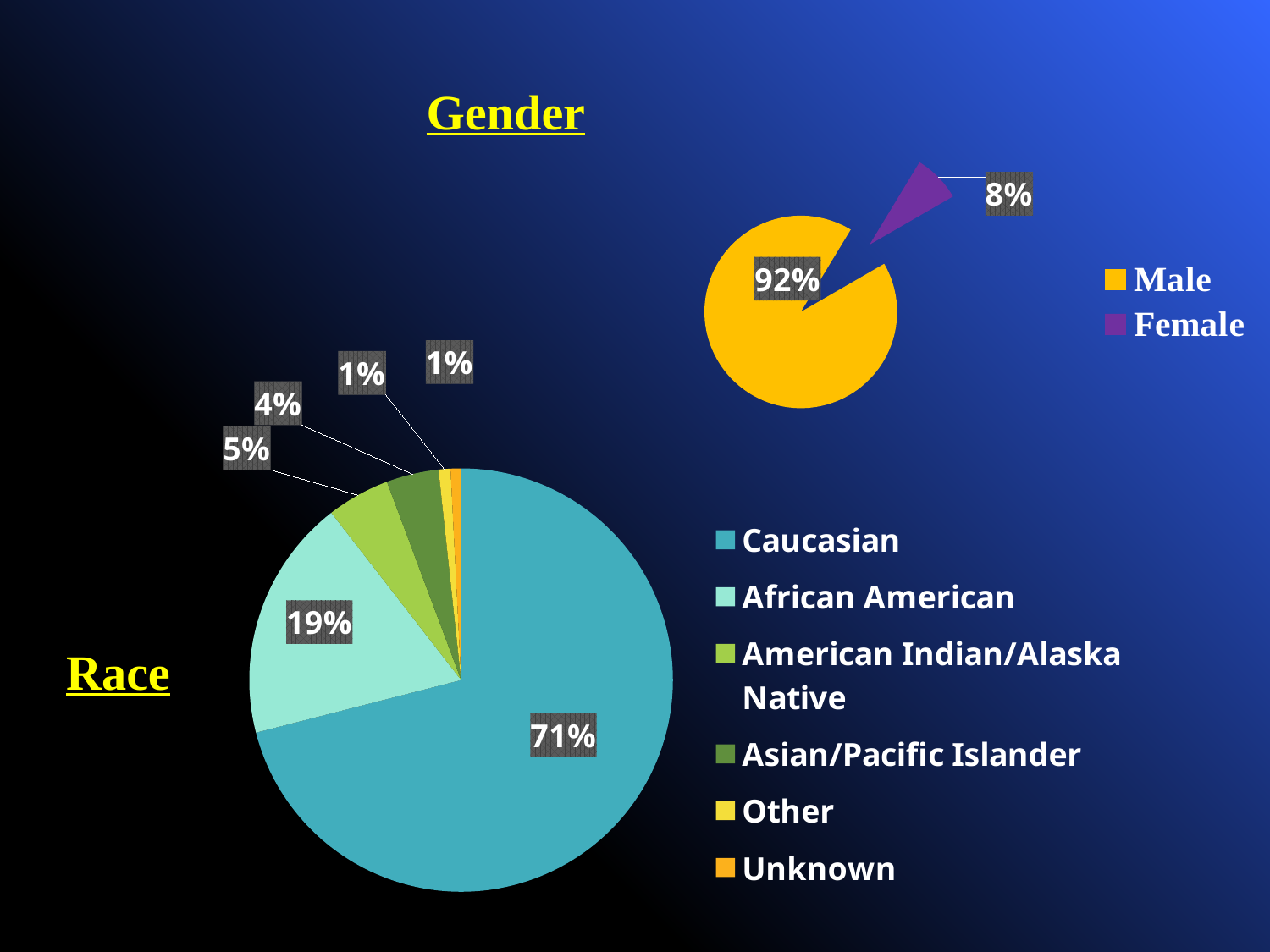
In the Race chart, which is larger, the African American share or the American Indian/Alaska Native share? African American In the Race chart, what percentage is American Indian/Alaska Native? 5% What type of chart is the Gender chart? Pie chart How many categories does the legend of the Race chart list? 6 In the Race chart, what percentage is Caucasian? 71% In the Gender chart, what percentage is Male? 92% In the Gender chart, what is the difference between the Male and Female shares? 84 percentage points In the Race chart, what percentage is Asian/Pacific Islander? 4% In the Gender chart, what percentage is Female? 8% In the Race chart, which category has the largest share? Caucasian In the Race chart, what is the difference between the Caucasian and African American shares? 52 percentage points In the Race chart, what percentage is African American? 19%